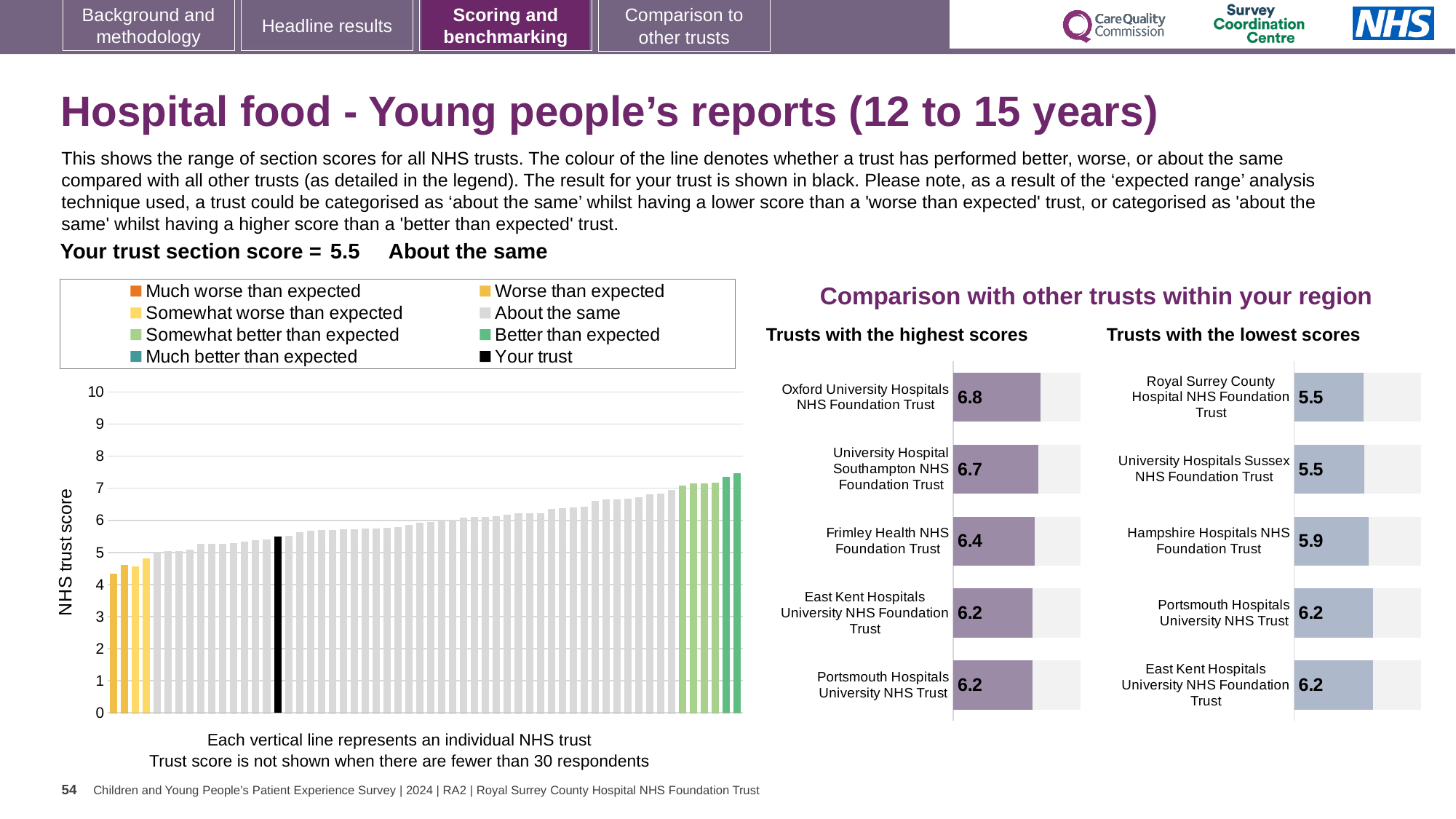
How many entries does the legend of the main 'NHS trust score' chart list? 8 In the 'Trusts with the highest scores' chart, what is the difference between the scores of Oxford University Hospitals NHS Foundation Trust and Frimley Health NHS Foundation Trust? 0.4 In the 'Trusts with the lowest scores' chart, what is the score for Hampshire Hospitals NHS Foundation Trust? 5.9 In the 'Trusts with the highest scores' chart, what is the score for Frimley Health NHS Foundation Trust? 6.4 How many trusts are shown in the 'Trusts with the highest scores' chart? 5 In the 'Trusts with the highest scores' chart, which trust has the highest score? Oxford University Hospitals NHS Foundation Trust In the main 'NHS trust score' chart on the left, what is the score of the black bar representing your trust? 5.5 In the 'Trusts with the lowest scores' chart, which has the larger score: Hampshire Hospitals NHS Foundation Trust or University Hospitals Sussex NHS Foundation Trust? Hampshire Hospitals NHS Foundation Trust In the 'Trusts with the lowest scores' chart, what is the score for Royal Surrey County Hospital NHS Foundation Trust? 5.5 In the 'Trusts with the lowest scores' chart, what is the difference between the scores of Hampshire Hospitals NHS Foundation Trust and Royal Surrey County Hospital NHS Foundation Trust? 0.4 In the 'Trusts with the highest scores' chart, what is the score for Oxford University Hospitals NHS Foundation Trust? 6.8 In the main 'NHS trust score' chart on the left, is the value of the tallest bar greater or less than 7? greater